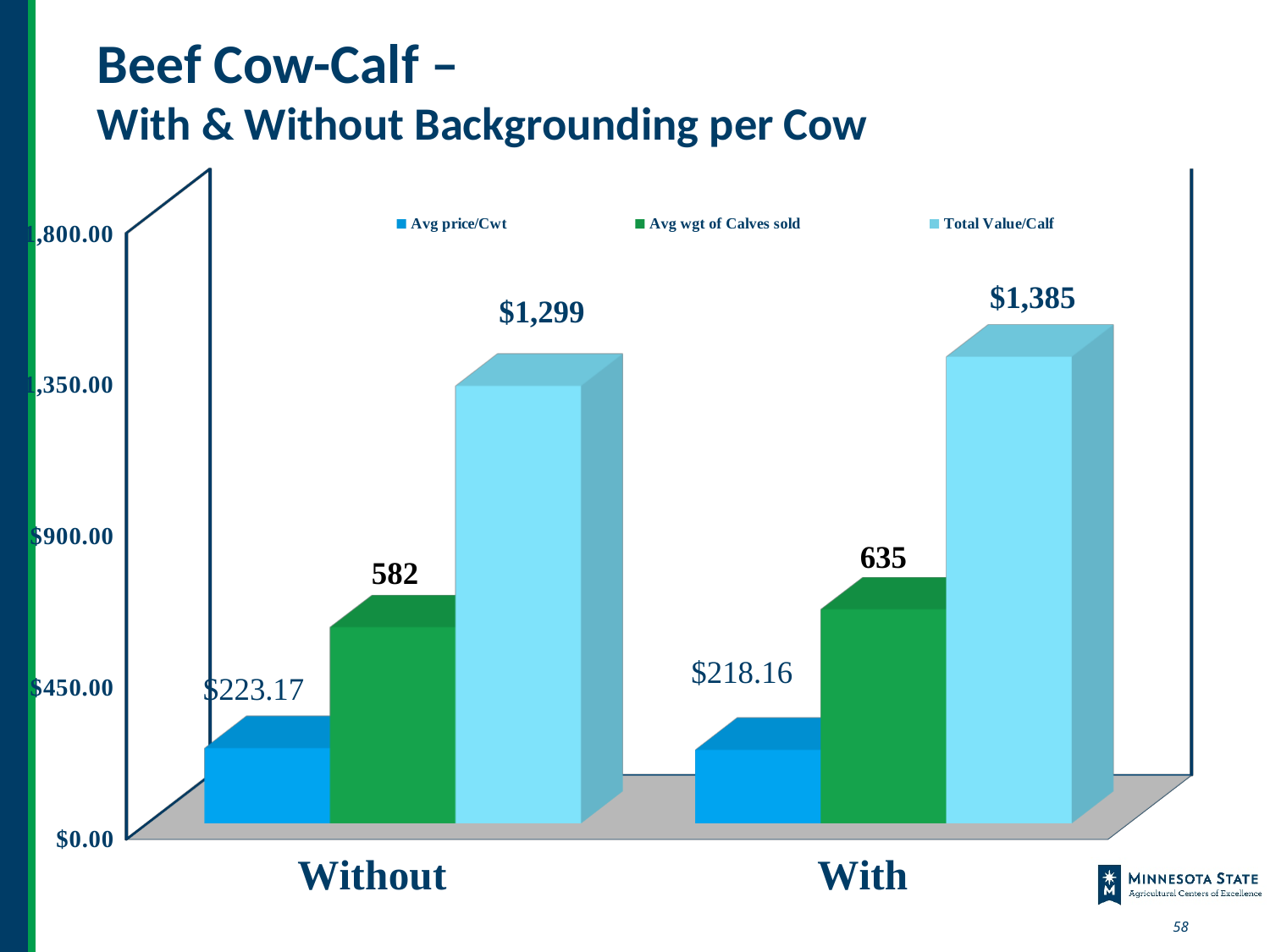
What is the Avg wgt of Calves sold for the Without category? 582 How many series does the legend list? 3 What kind of chart is shown on the slide? bar chart What is the difference in Avg wgt of Calves sold between With and Without? 53 Which category has the lower Avg price/Cwt? With What is the Avg price/Cwt for the With category? $218.16 What is the Total Value/Calf for the Without category? $1,299 Is the Avg price/Cwt for Without larger or smaller than the Avg price/Cwt for With? larger What is the difference in Total Value/Calf between With and Without? $86 What is the Total Value/Calf for the With category? $1,385 How many categories are shown on the x axis? 2 Which category has the higher Total Value/Calf? With